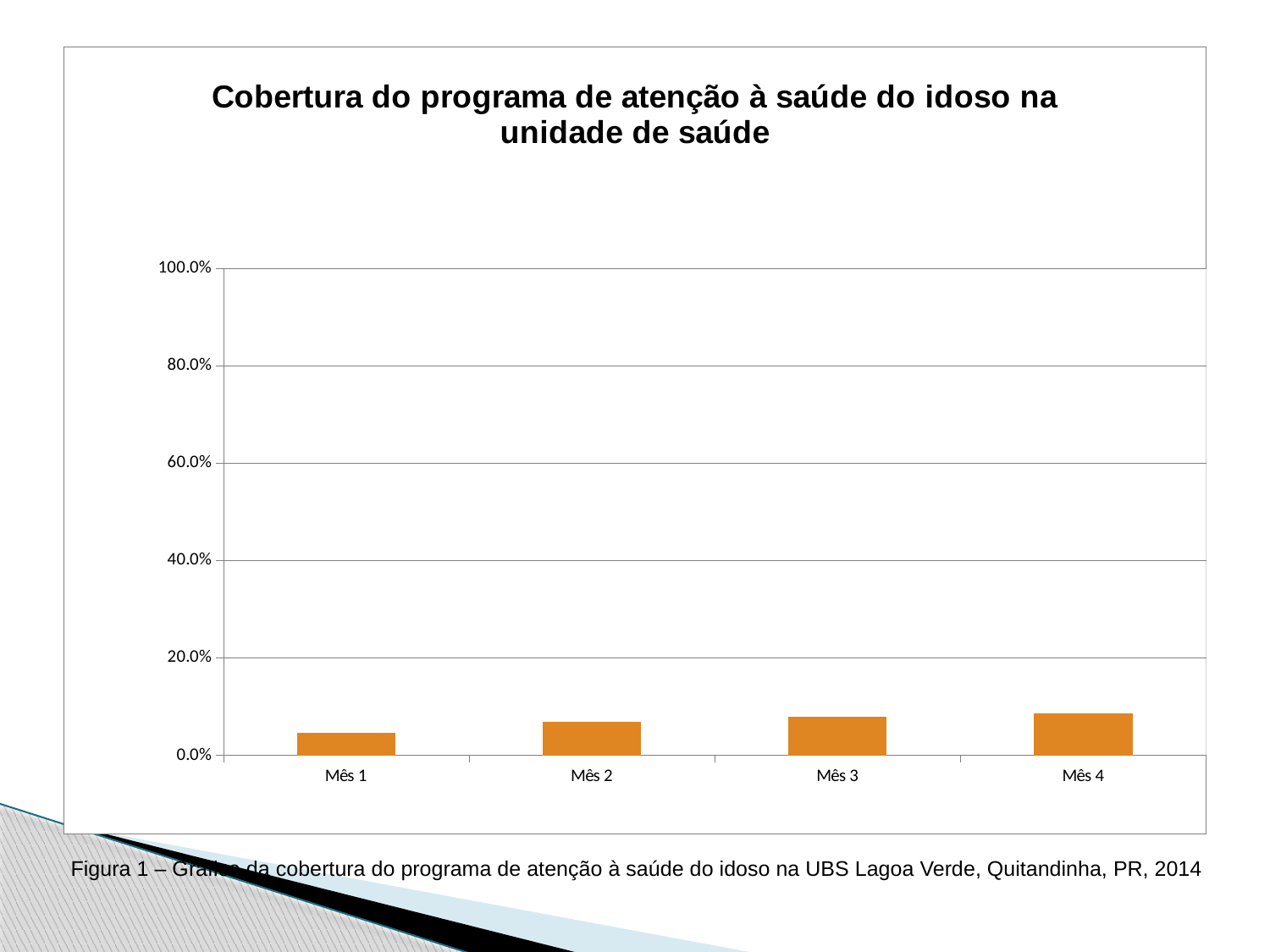
Is the value for Mês 3 greater or less than 40.0%? less How many months (categories) are plotted on the x axis? 4 Do the values rise or fall from Mês 1 to Mês 4? rise Which is larger, the value for Mês 1 or the value for Mês 2? Mês 2 Is the value for Mês 1 greater or less than 20.0%? less What kind of chart is shown on the slide? bar chart Which month has the lowest coverage value? Mês 1 What is the title of the chart? Cobertura do programa de atenção à saúde do idoso na unidade de saúde Is the value for Mês 4 greater or less than 20.0%? less Which is larger, the value for Mês 1 or the value for Mês 4? Mês 4 What is the highest value shown on the y axis? 100.0%